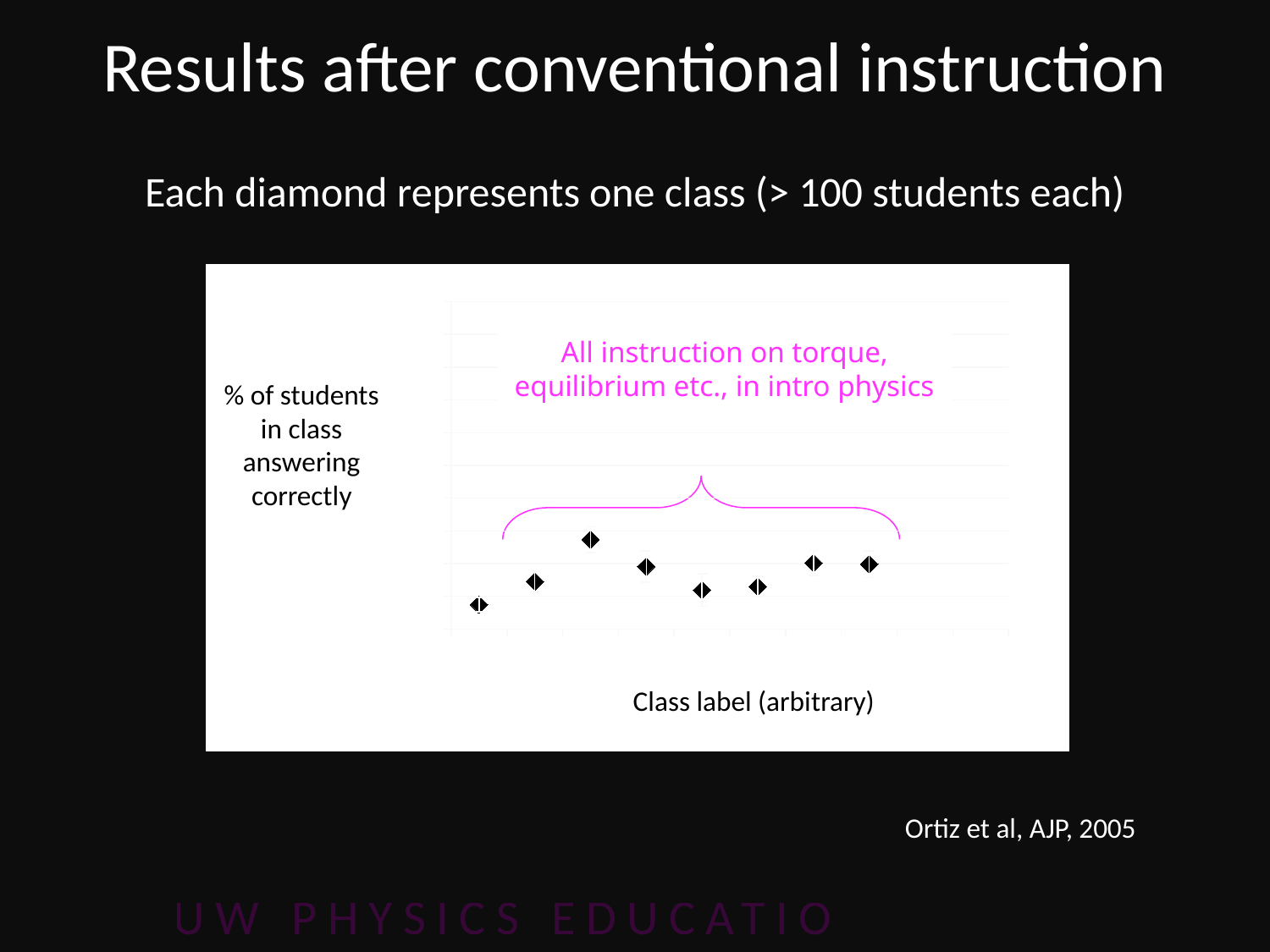
What is the label on the vertical axis of the chart? % of students in class answering correctly Which diamond on the chart has the highest value? the third diamond from the left What does the magenta annotation above the bracket on the chart say? All instruction on torque, equilibrium etc., in intro physics What kind of chart is shown on the slide? scatter chart Is the leftmost diamond higher or lower than the rightmost diamond? lower How many diamonds (classes) are plotted on the chart? 8 Is the fourth diamond from the left higher or lower than the fifth diamond from the left? higher Is the second diamond from the left higher or lower than the third diamond from the left? lower Which diamond on the chart has the lowest value? the leftmost diamond